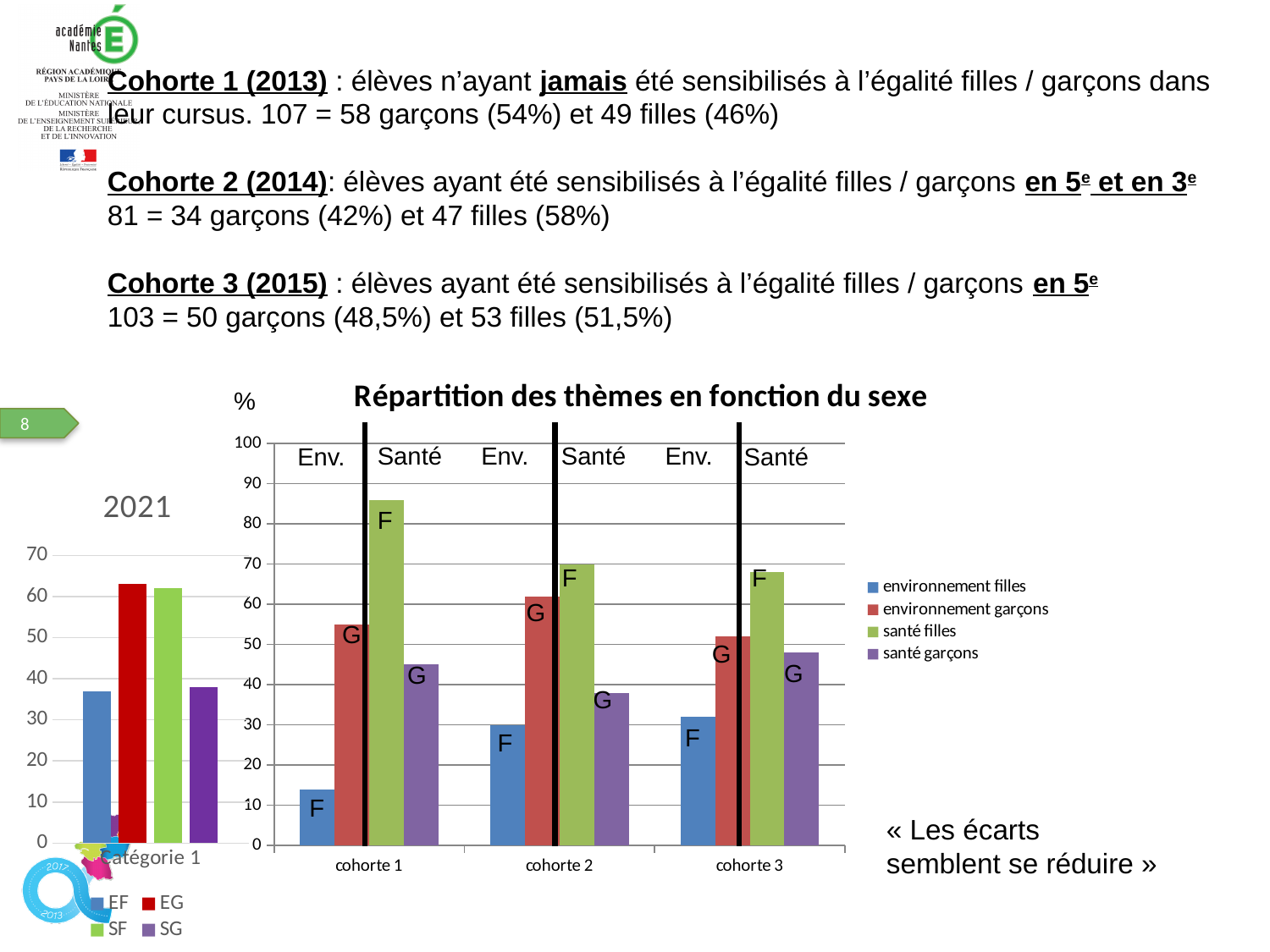
In the chart titled 'Répartition des thèmes en fonction du sexe', which series has the highest value for cohorte 1? santé filles In the chart titled 'Répartition des thèmes en fonction du sexe', which is larger for cohorte 3: environnement garçons or santé filles? santé filles In the chart titled 'Répartition des thèmes en fonction du sexe', how many series does the legend list? 4 In the chart titled 'Répartition des thèmes en fonction du sexe', is the value for environnement filles in cohorte 1 greater or less than 20? less In the chart titled 'Répartition des thèmes en fonction du sexe', how many cohort categories are shown on the x axis? 3 In the small chart on the left labelled '2021', which is larger: EF or EG? EG In the chart titled 'Répartition des thèmes en fonction du sexe', what kind of chart is shown? bar chart In the chart titled 'Répartition des thèmes en fonction du sexe', what unit is shown on the vertical axis? % In the chart titled 'Répartition des thèmes en fonction du sexe', is the value for santé filles in cohorte 1 greater or less than 80? greater In the chart titled 'Répartition des thèmes en fonction du sexe', does the value for environnement filles rise or fall from cohorte 1 to cohorte 3? rise In the chart titled 'Répartition des thèmes en fonction du sexe', which series has the lowest value for cohorte 1? environnement filles